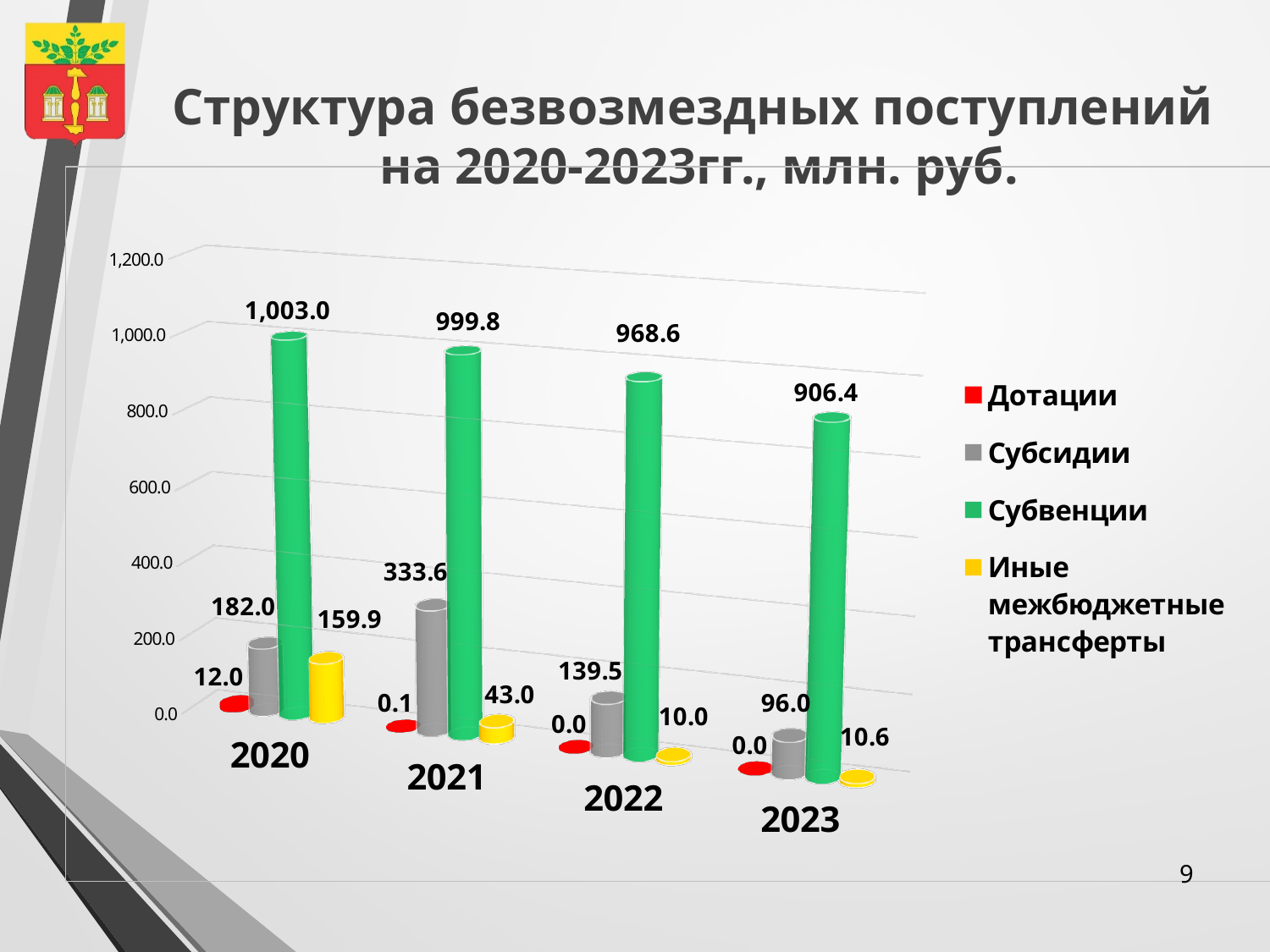
In which year is the value for Субвенции the lowest? 2023 What type of chart is shown on the slide? Bar chart What is the value for Дотации in 2020? 12.0 What is the value for Субвенции in 2020? 1,003.0 How many series does the legend list? 4 How many years are shown on the x axis? 4 What is the value for Субсидии in 2021? 333.6 What is the value for Иные межбюджетные трансферты in 2023? 10.6 What is the difference between the Субвенции values for 2020 and 2023? 96.6 Which is larger: Иные межбюджетные трансферты in 2020 or Субсидии in 2020? Субсидии in 2020 In which year is the value for Субсидии the highest? 2021 Do the Субвенции values rise or fall from 2020 to 2023? Fall